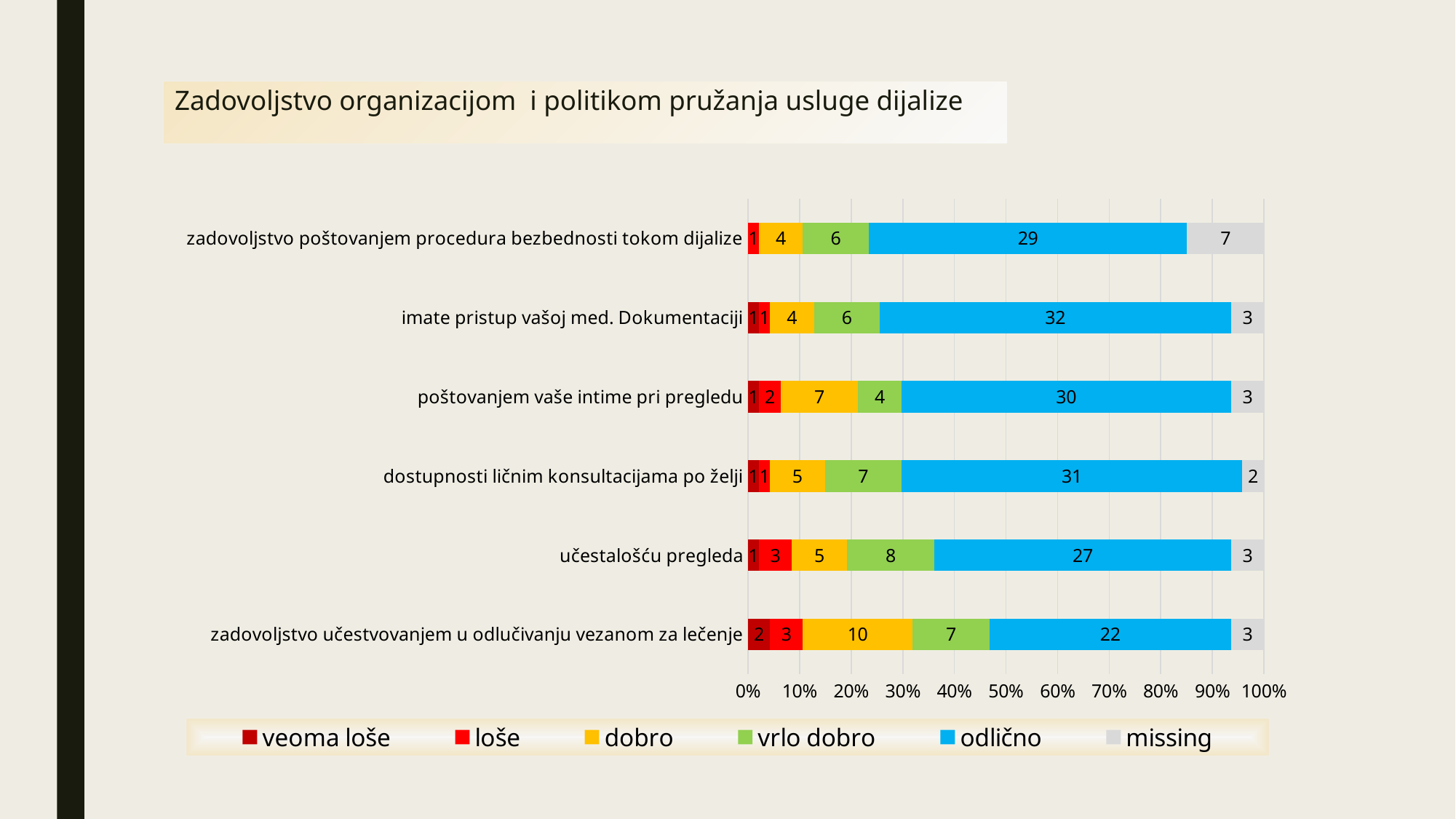
What is the value of the 'odlično' segment for 'imate pristup vašoj med. Dokumentaciji'? 32 Which category has the highest 'odlično' value? imate pristup vašoj med. Dokumentaciji How many categories are shown on the chart? 6 What kind of chart is shown on the slide? stacked bar chart How many series does the legend list? 6 What is the value of the 'dobro' segment for 'zadovoljstvo učestvovanjem u odlučivanju vezanom za lečenje'? 10 Which is larger: the 'vrlo dobro' value for 'učestalošću pregleda' or for 'poštovanjem vaše intime pri pregledu'? učestalošću pregleda What is the difference between the 'odlično' values for 'imate pristup vašoj med. Dokumentaciji' and 'učestalošću pregleda'? 5 Which category has the lowest 'odlično' value? zadovoljstvo učestvovanjem u odlučivanju vezanom za lečenje What is the total of all segments in the bar for 'učestalošću pregleda'? 47 What is the value of the 'missing' segment for 'zadovoljstvo poštovanjem procedura bezbednosti tokom dijalize'? 7 What is the title of the chart? Zadovoljstvo organizacijom i politikom pružanja usluge dijalize